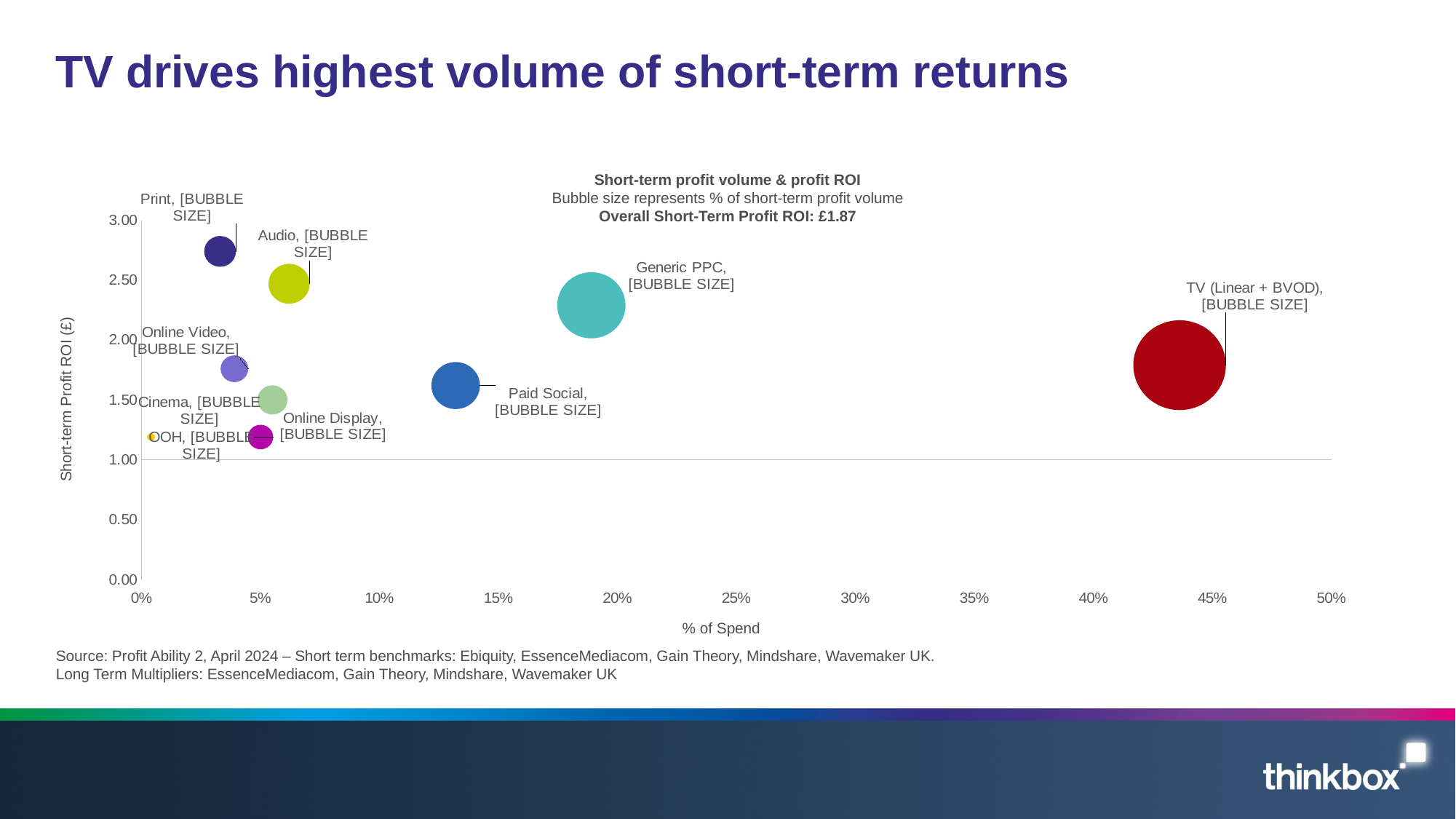
Which channel has the highest % of spend? TV (Linear + BVOD) Which channel has the largest bubble (largest share of short-term profit volume)? TV (Linear + BVOD) What overall short-term profit ROI is stated in the chart subtitle? £1.87 Which channel has the lowest % of spend? OOH Which has the higher short-term profit ROI, Generic PPC or Paid Social? Generic PPC What kind of chart is shown on the slide? Bubble chart Is the % of spend for TV (Linear + BVOD) greater or less than 40%? greater Which channel has the highest short-term profit ROI? Print Is the short-term profit ROI for Paid Social greater or less than 2.00? less Is the short-term profit ROI for Generic PPC greater or less than 2.00? greater How many bubbles (media channels) are plotted on the chart? 9 What is the label on the y axis of the chart? Short-term Profit ROI (£)